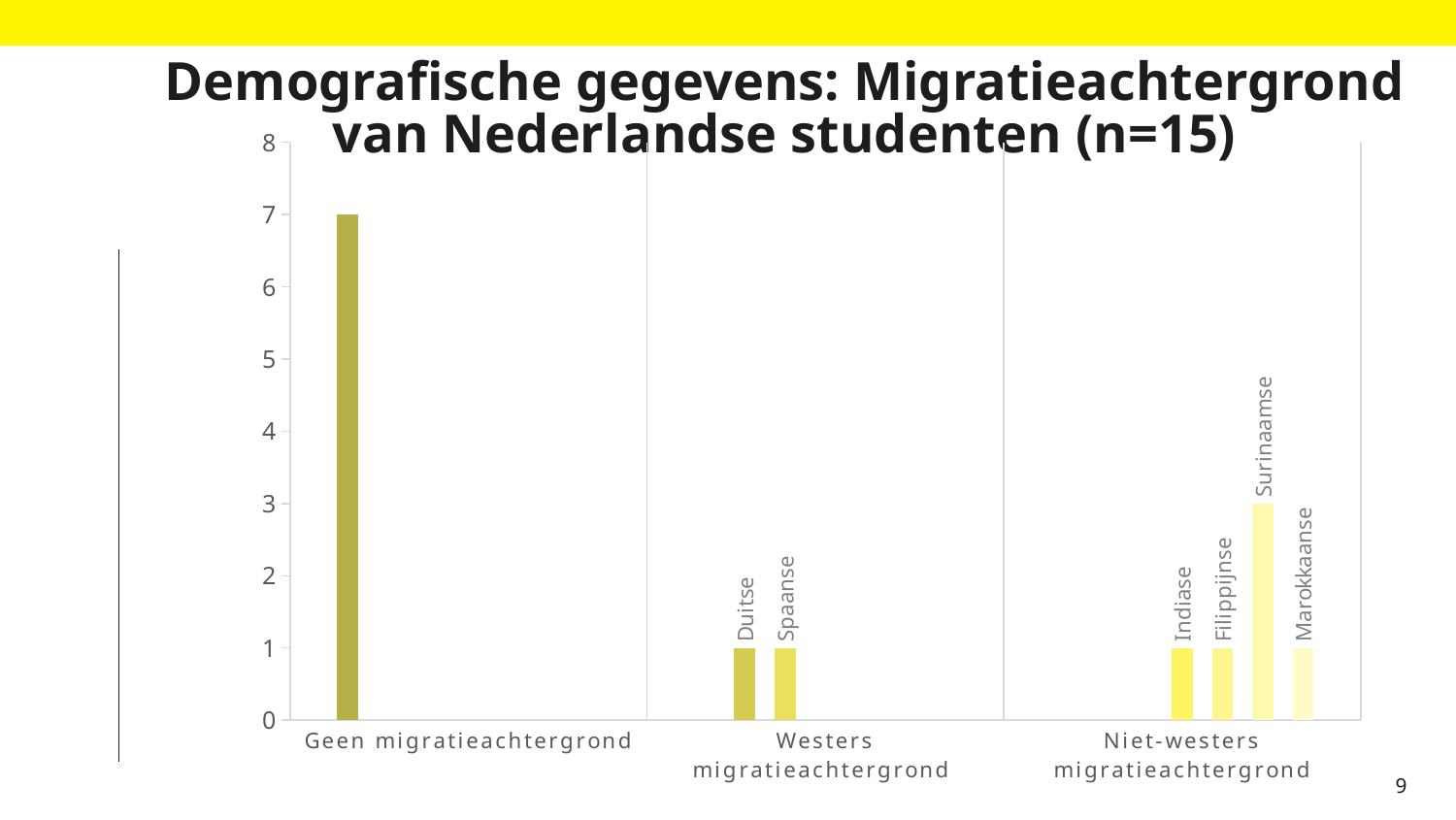
What is the difference between the Geen migratieachtergrond bar and the Surinaamse bar? 4 What kind of chart is shown on the slide? bar chart How many bars are plotted in total on the chart? 7 What is the title of the chart? Demografische gegevens: Migratieachtergrond van Nederlandse studenten (n=15) What is the value of the Surinaamse bar in the Niet-westers migratieachtergrond group? 3 How many category groups are shown along the x axis? 3 What is the value of the Duitse bar in the Westers migratieachtergrond group? 1 Is the value for Geen migratieachtergrond greater or less than 5? greater Which bar is the highest in the chart? Geen migratieachtergrond How many bars are shown in the Niet-westers migratieachtergrond group? 4 What is the value of the bar for Geen migratieachtergrond? 7 Which is larger, the Surinaamse bar or the Marokkaanse bar? Surinaamse